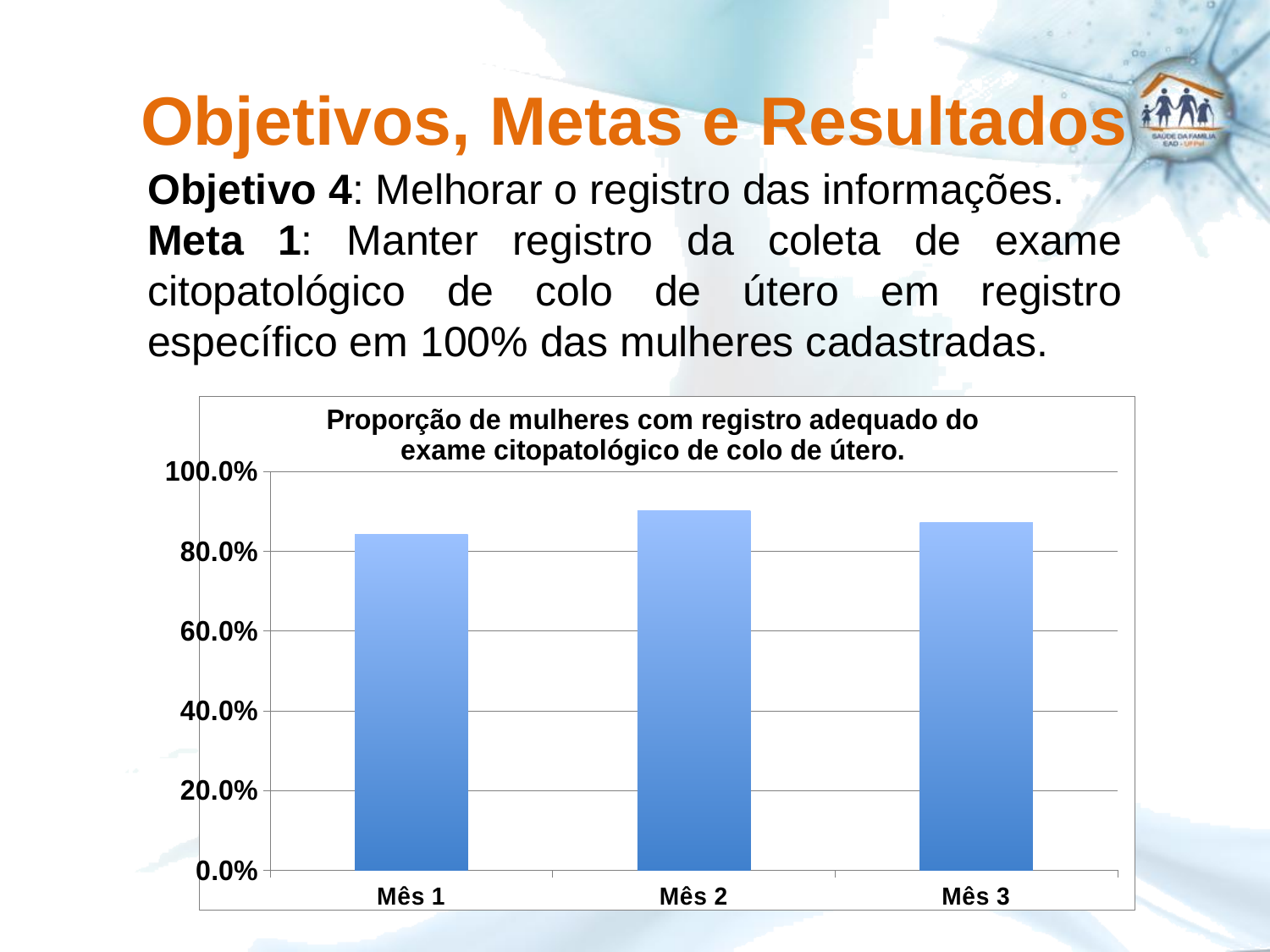
Is the value for Mês 2 greater or less than 100.0%? less What is the title of the chart? Proporção de mulheres com registro adequado do exame citopatológico de colo de útero. Which month has the highest proportion of women with adequate registration? Mês 2 Which is larger, the value for Mês 1 or the value for Mês 2? Mês 2 Does the value rise or fall from Mês 2 to Mês 3? fall What kind of chart is shown on the slide? bar chart Is the value for Mês 1 greater or less than 80.0%? greater What is the highest value shown on the vertical axis of the chart? 100.0% Is the value for Mês 3 greater or less than 80.0%? greater How many categories (months) are plotted on the chart? 3 Does the value rise or fall from Mês 1 to Mês 2? rise